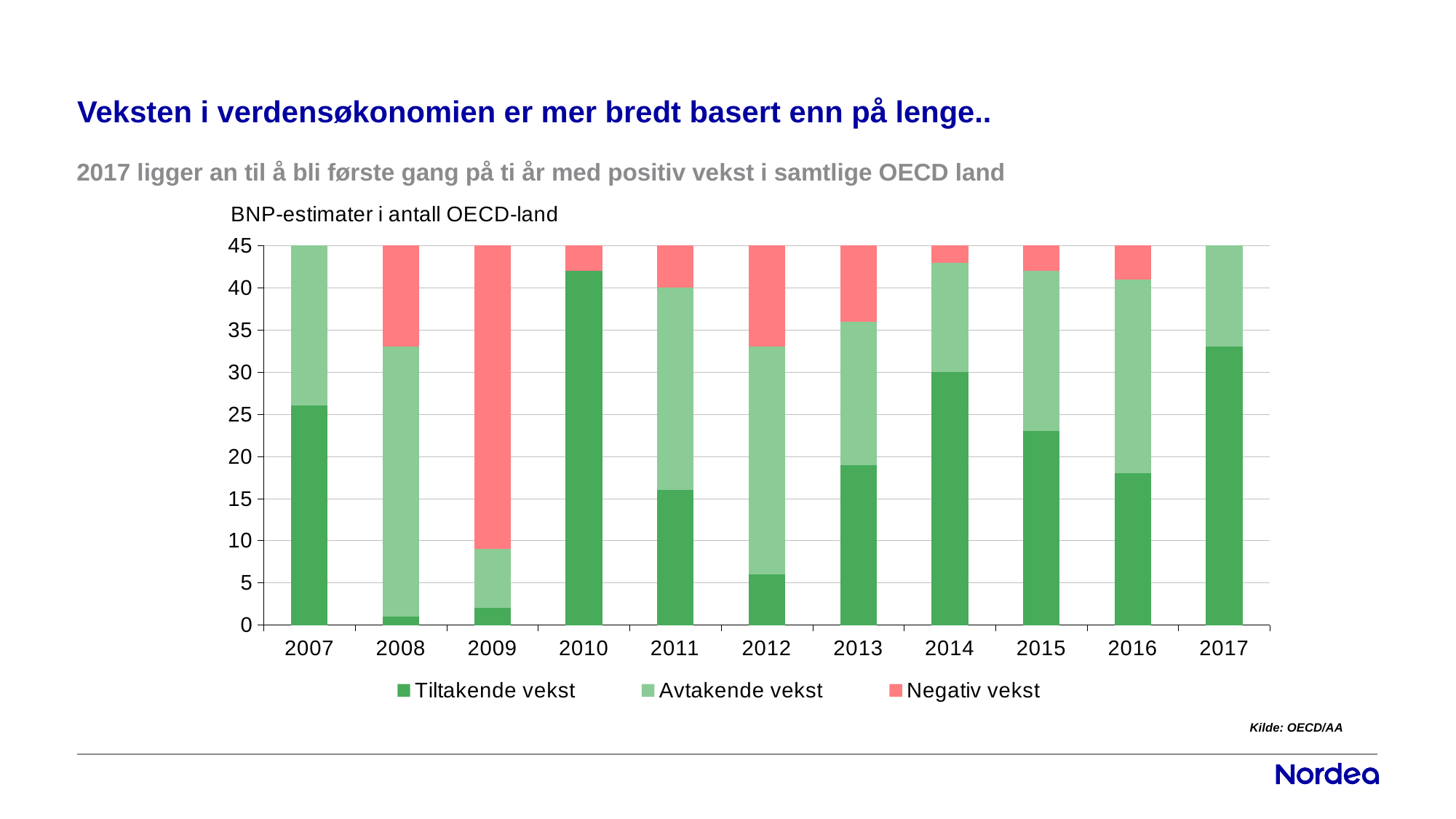
Is the value for Tiltakende vekst in 2010 greater or less than 40? greater What is the total height of the stacked bar for 2007? 45 Which year has the highest value for Negativ vekst? 2009 What kind of chart is shown on the slide? Stacked bar chart Which year has the highest value for Tiltakende vekst? 2010 How many years are shown on the x axis? 11 Does Tiltakende vekst rise or fall from 2014 to 2016? Falls What is the value of Tiltakende vekst for 2014? 30 Is the value for Tiltakende vekst in 2012 greater or less than 10? less How many series does the legend list? 3 What is the title of the chart? BNP-estimater i antall OECD-land Which is larger, Tiltakende vekst in 2010 or in 2014? 2010